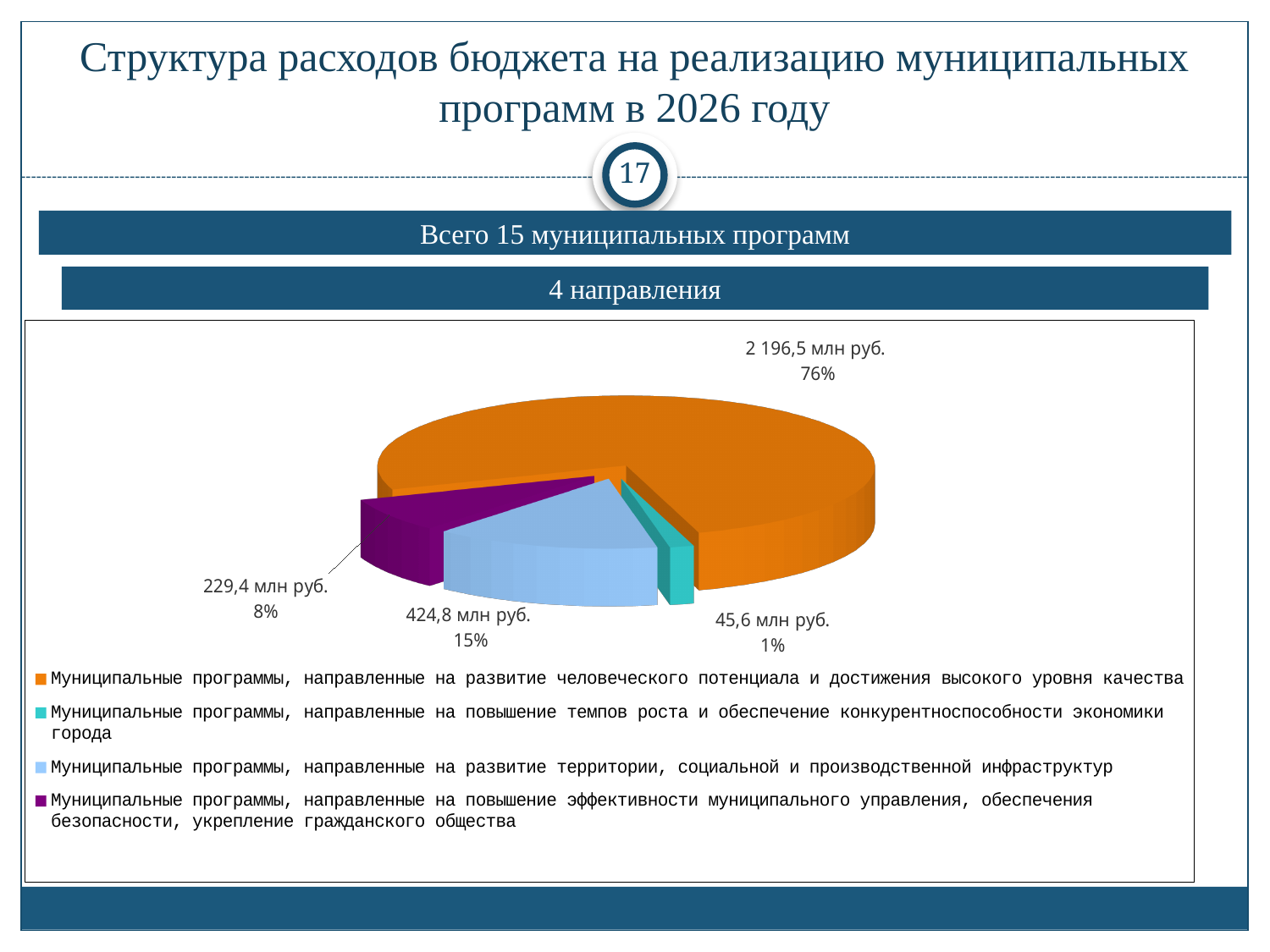
What kind of chart is shown on the slide? pie chart What is the value of the slice for municipal programmes aimed at increasing growth rates and competitiveness of the city economy (повышение темпов роста)? 45,6 млн руб. What share of the pie does the slice for programmes aimed at developing territory and infrastructure take? 15% How many entries does the legend of the pie chart list? 4 What is the difference between the slice for developing territory and infrastructure (424,8 млн руб.) and the slice for increasing efficiency of municipal management (229,4 млн руб.)? 195,4 млн руб. What is the value of the slice for municipal programmes aimed at increasing the efficiency of municipal management (повышение эффективности муниципального управления)? 229,4 млн руб. What is the value of the slice for municipal programmes aimed at developing human potential (развитие человеческого потенциала)? 2 196,5 млн руб. Which category has the smallest slice in the pie chart? Муниципальные программы, направленные на повышение темпов роста и обеспечение конкурентноспособности экономики города How many slices does the pie chart have? 4 What share of the pie does the slice for programmes aimed at developing human potential take? 76% What is the value of the slice for municipal programmes aimed at developing territory, social and production infrastructure (развитие территории)? 424,8 млн руб. Which colour represents the programmes aimed at developing human potential in the pie chart? orange